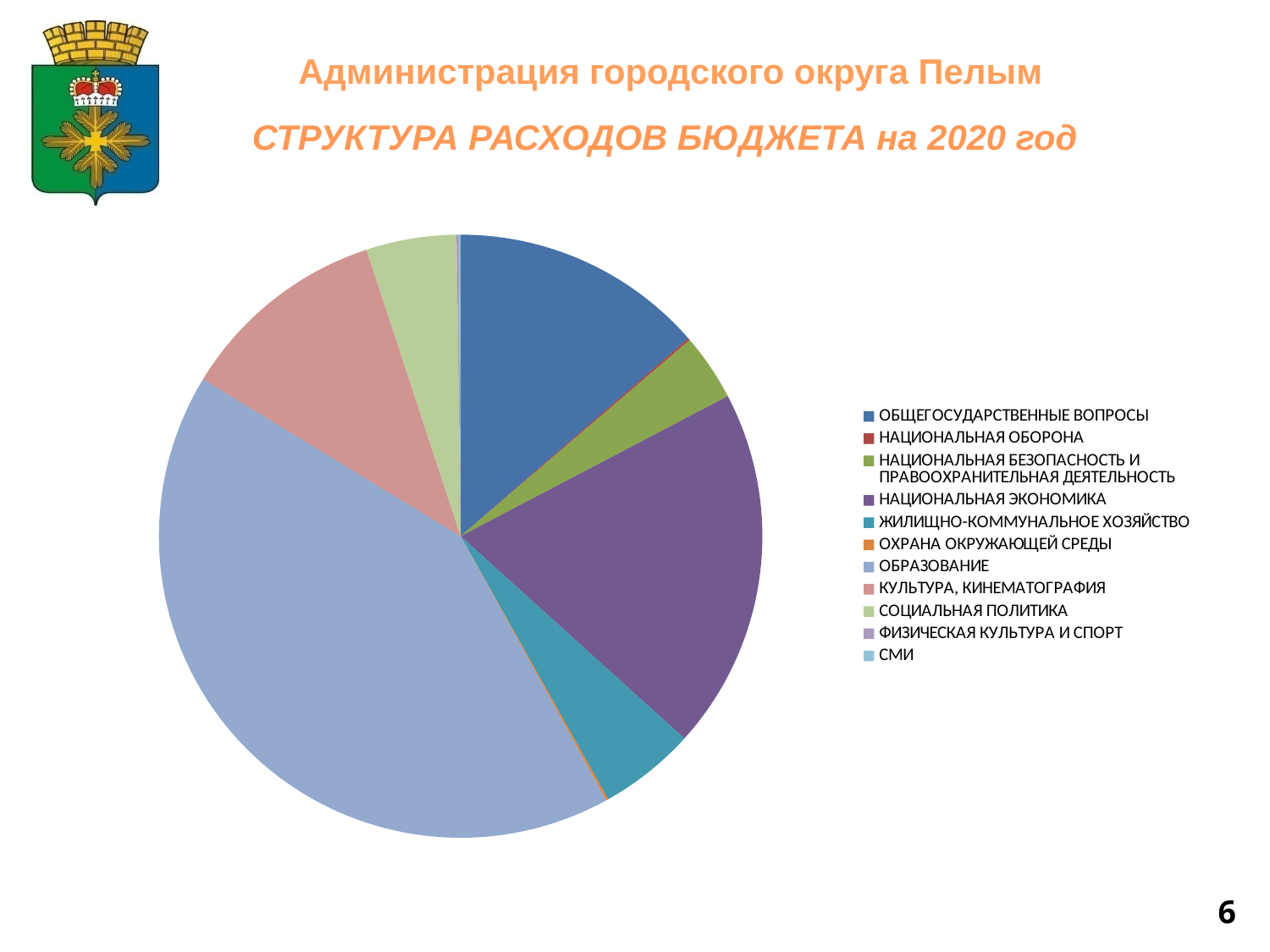
What is the title of the chart on the slide? СТРУКТУРА РАСХОДОВ БЮДЖЕТА на 2020 год Which category is the first entry in the pie chart's legend? ОБЩЕГОСУДАРСТВЕННЫЕ ВОПРОСЫ Which slice is larger: НАЦИОНАЛЬНАЯ ЭКОНОМИКА or ОБЩЕГОСУДАРСТВЕННЫЕ ВОПРОСЫ? НАЦИОНАЛЬНАЯ ЭКОНОМИКА Which slice is larger: ЖИЛИЩНО-КОММУНАЛЬНОЕ ХОЗЯЙСТВО or НАЦИОНАЛЬНАЯ БЕЗОПАСНОСТЬ И ПРАВООХРАНИТЕЛЬНАЯ ДЕЯТЕЛЬНОСТЬ? ЖИЛИЩНО-КОММУНАЛЬНОЕ ХОЗЯЙСТВО Which slice is larger: ОБЩЕГОСУДАРСТВЕННЫЕ ВОПРОСЫ or СОЦИАЛЬНАЯ ПОЛИТИКА? ОБЩЕГОСУДАРСТВЕННЫЕ ВОПРОСЫ What kind of chart is shown on the slide? Pie chart Which category has the largest slice in the pie chart? ОБРАЗОВАНИЕ How many expenditure categories does the legend of the pie chart list? 11